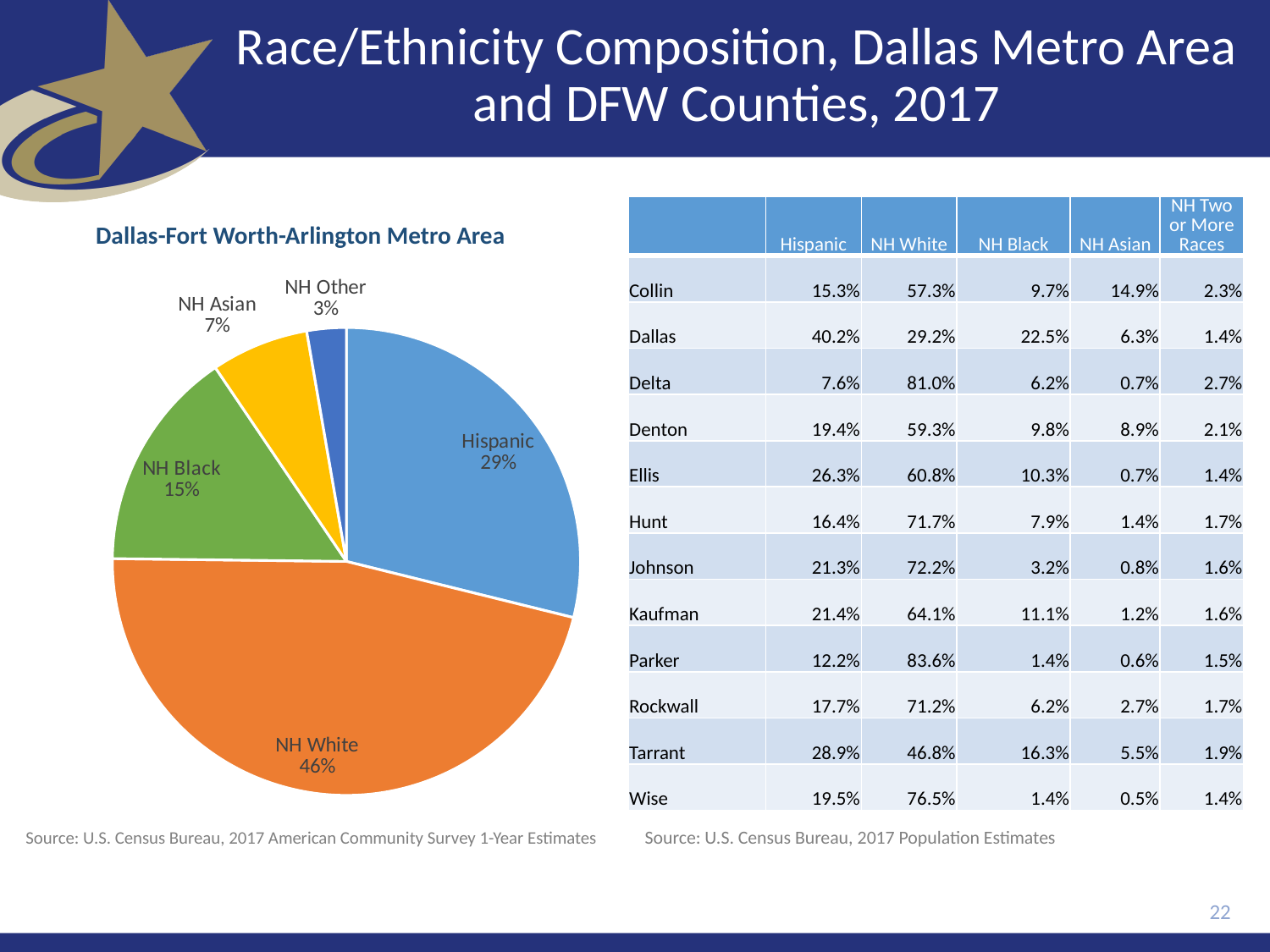
In the pie chart, which is larger, NH Black or NH Asian? NH Black In the pie chart, what share is Hispanic? 29% Which slice of the pie chart is the largest? NH White In the pie chart, what is the difference between the NH White share and the Hispanic share? 17% In the pie chart, what share is NH White? 46% In the pie chart, what share is NH Asian? 7% In the pie chart, what share is NH Other? 3% What is the title of the pie chart? Dallas-Fort Worth-Arlington Metro Area Which slice of the pie chart is the smallest? NH Other In the pie chart, what share is NH Black? 15% What kind of chart is shown on the slide? Pie chart How many slices does the pie chart have? 5